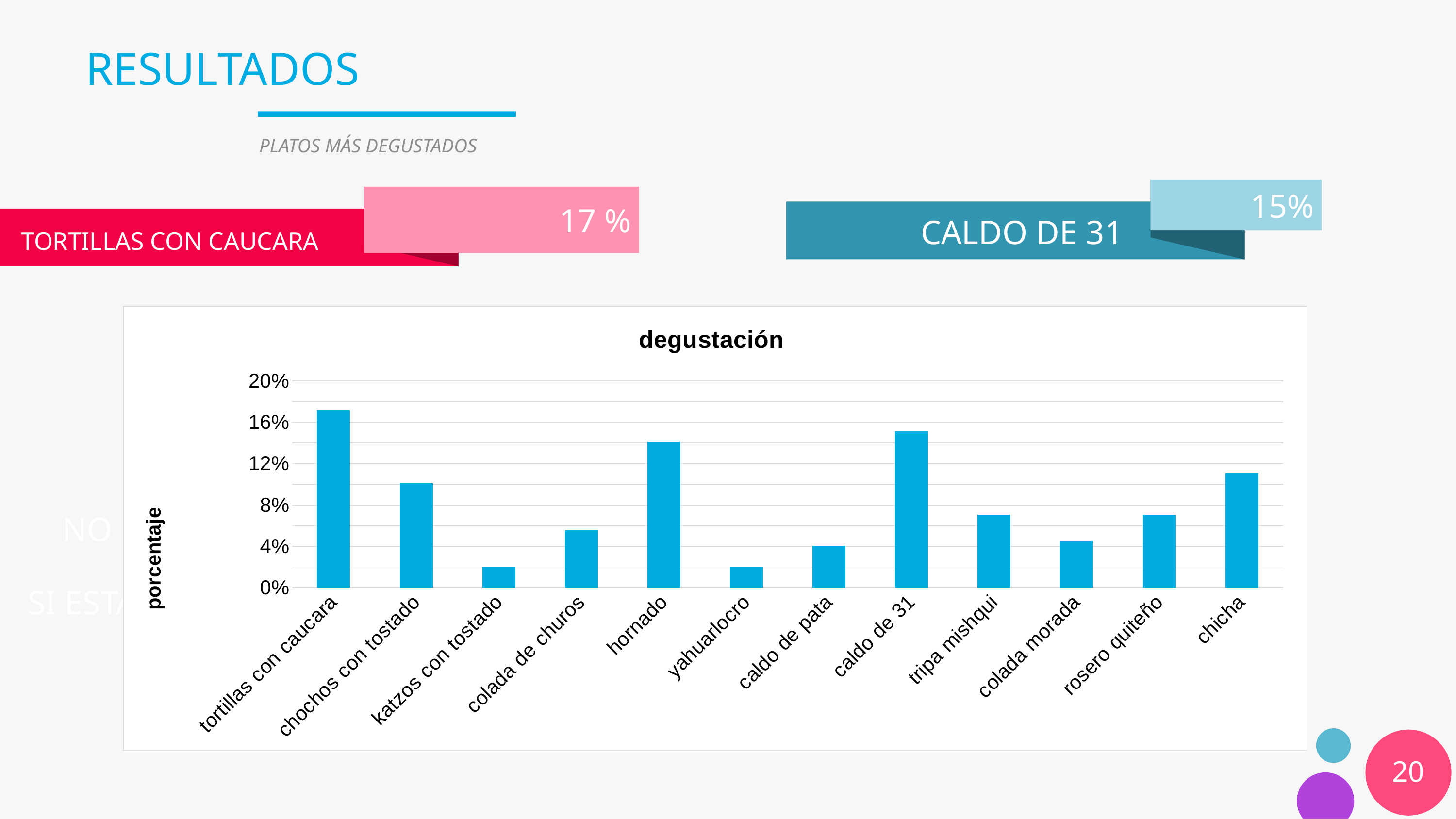
What type of chart is shown on the slide? bar chart How many dishes (categories) are shown on the x axis of the chart? 12 Is the value for chicha greater or less than 12%? less Is the value for tripa mishqui greater or less than 4%? greater Is the value for katzos con tostado greater or less than 4%? less Which is larger, the value for hornado or the value for chicha? hornado Which is larger, the value for tortillas con caucara or the value for caldo de 31? tortillas con caucara What is the label on the vertical axis of the chart? porcentaje Which dish has the highest bar in the chart? tortillas con caucara What is the title of the chart? degustación